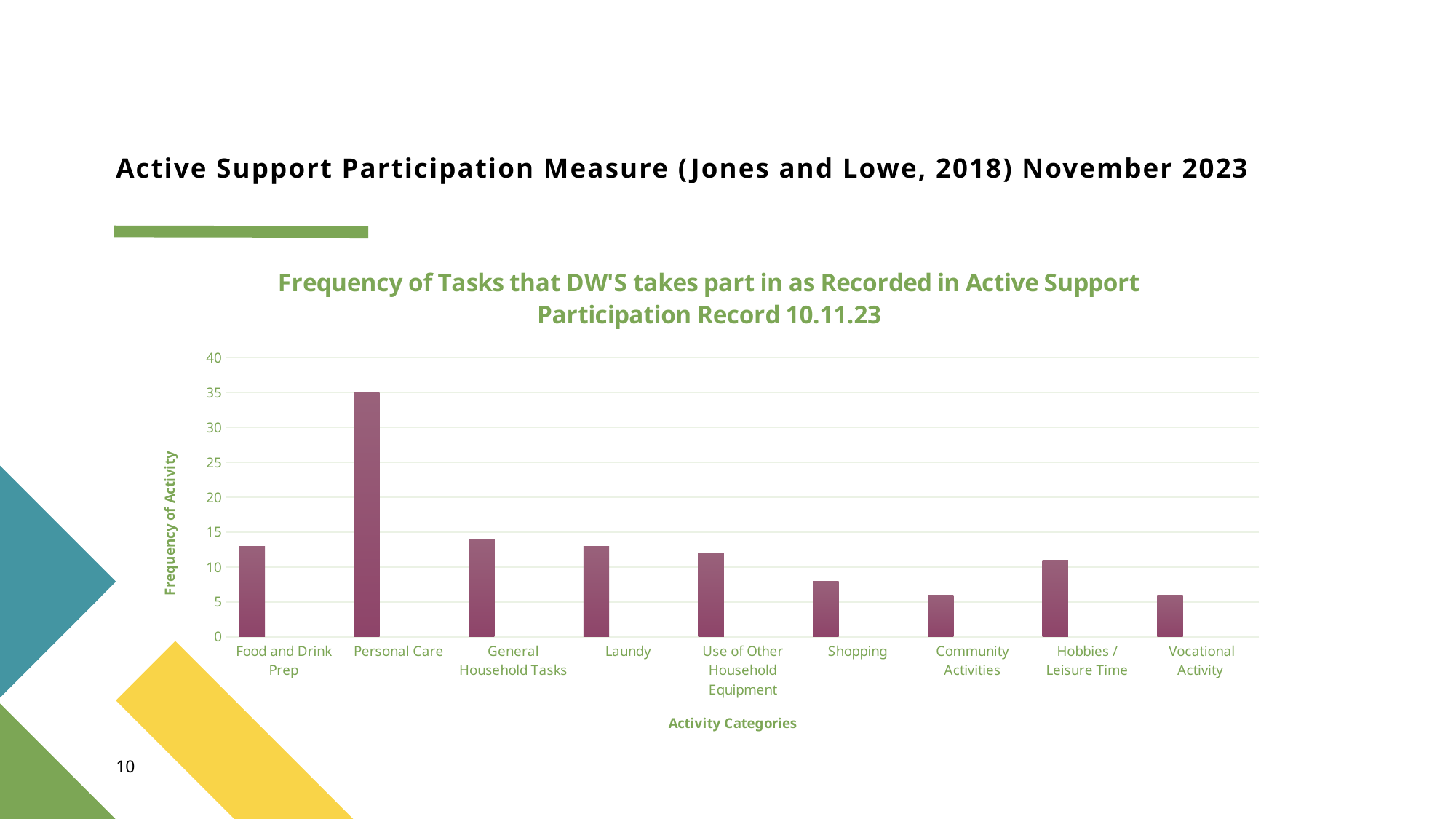
What type of chart is shown on the slide? Bar chart What is the title of the vertical axis? Frequency of Activity Is the value for Shopping greater or less than 10? less What is the title of the horizontal axis? Activity Categories Which is larger, the value for Personal Care or the value for Laundy? Personal Care What is the frequency of activity for Personal Care? 35 Which activity category has the highest frequency of activity? Personal Care How many activity categories are shown on the x axis? 9 Is the value for Food and Drink Prep greater or less than 10? greater Is the value for General Household Tasks greater or less than 15? less Which is larger, the value for Shopping or the value for Hobbies / Leisure Time? Hobbies / Leisure Time